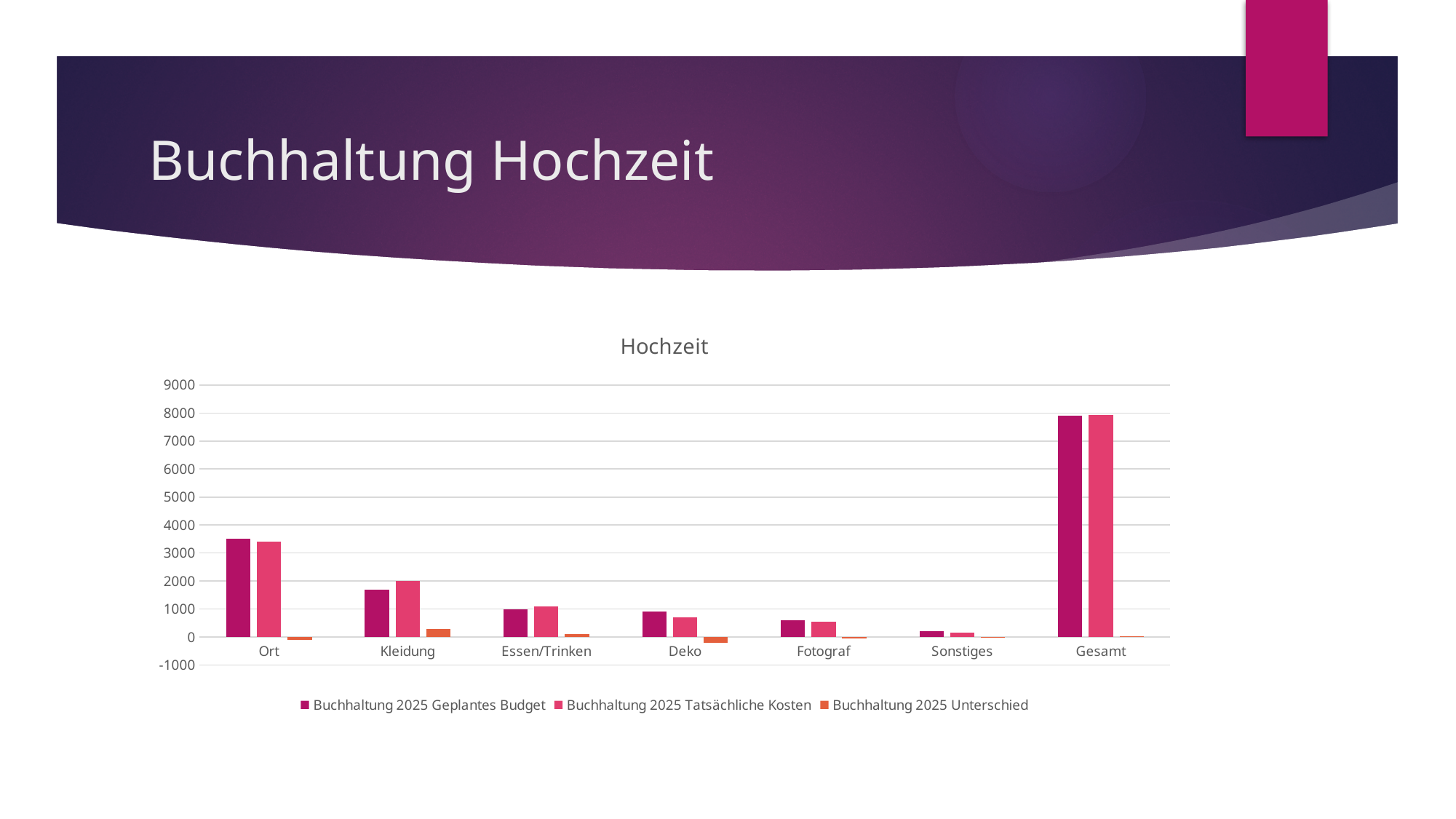
For Kleidung, which is larger: Buchhaltung 2025 Geplantes Budget or Buchhaltung 2025 Tatsächliche Kosten? Buchhaltung 2025 Tatsächliche Kosten How many categories are shown on the x axis of the chart? 7 Which category has the highest value for Buchhaltung 2025 Geplantes Budget? Gesamt Is the Buchhaltung 2025 Tatsächliche Kosten value for Deko greater or less than 1000? less Is the Buchhaltung 2025 Geplantes Budget value for Ort greater or less than 3000? greater What kind of chart is shown on the slide? bar chart Is the Buchhaltung 2025 Tatsächliche Kosten value for Kleidung greater or less than 1000? greater How many series does the chart's legend list? 3 What is the title of the chart? Hochzeit For Deko, which is larger: Buchhaltung 2025 Geplantes Budget or Buchhaltung 2025 Tatsächliche Kosten? Buchhaltung 2025 Geplantes Budget Which category has the lowest value for Buchhaltung 2025 Tatsächliche Kosten? Sonstiges